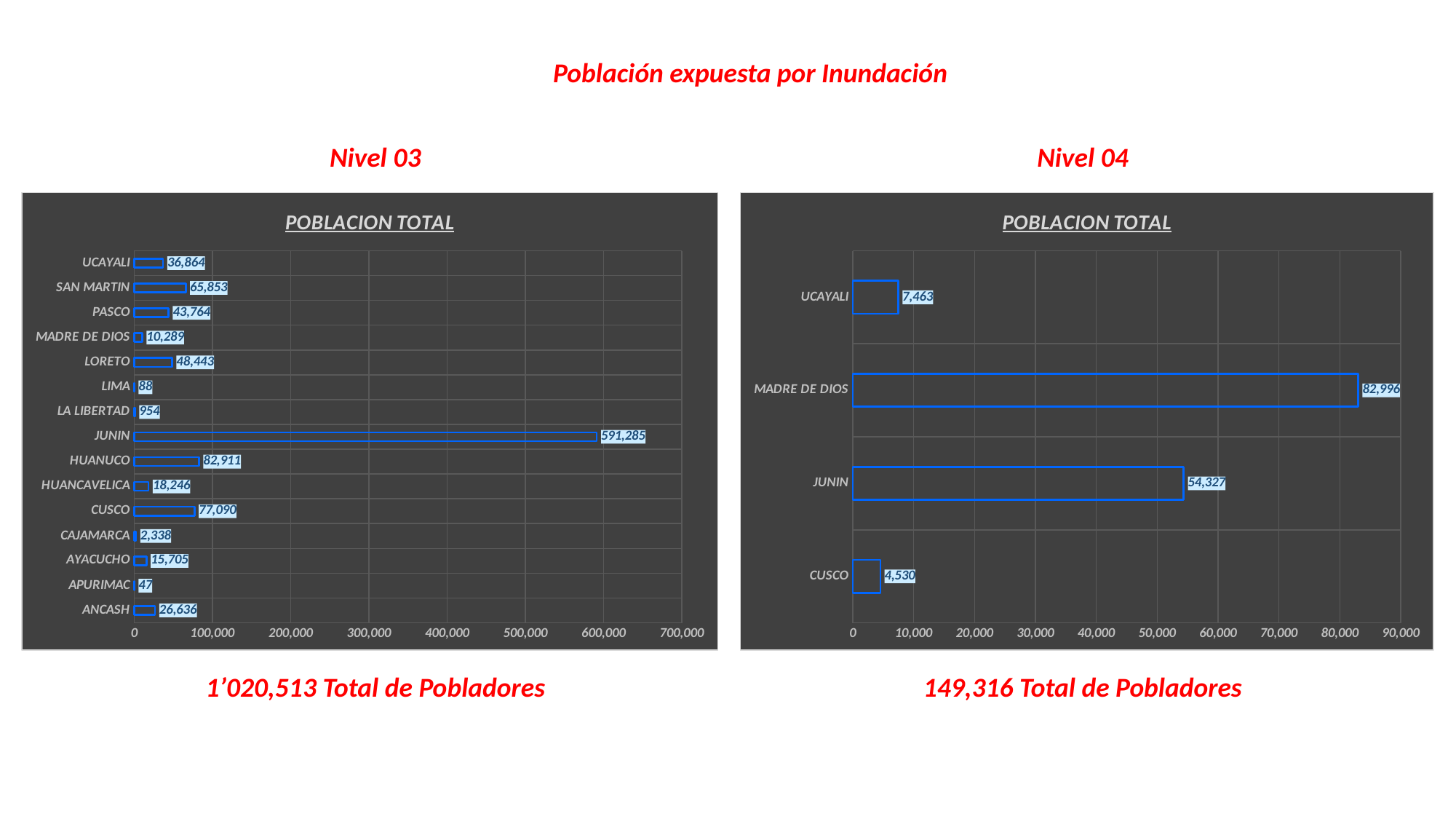
In the Nivel 03 chart, which category has the lowest value? APURIMAC How many categories are shown in the Nivel 04 chart? 4 What type of chart is the Nivel 04 chart? Bar chart In the Nivel 04 chart, what is the difference between MADRE DE DIOS and JUNIN? 28,669 In the Nivel 03 chart, which category has the highest value? JUNIN In the Nivel 03 chart, which is larger, CUSCO or SAN MARTIN? CUSCO In the Nivel 04 chart, what is the value for MADRE DE DIOS? 82,996 In the Nivel 03 chart, what is the value for HUANUCO? 82,911 In the Nivel 04 chart, which category has the lowest value? CUSCO In the Nivel 03 chart, what is the value for JUNIN? 591,285 How many categories are shown in the Nivel 03 chart? 15 In the Nivel 04 chart, what is the value for CUSCO? 4,530